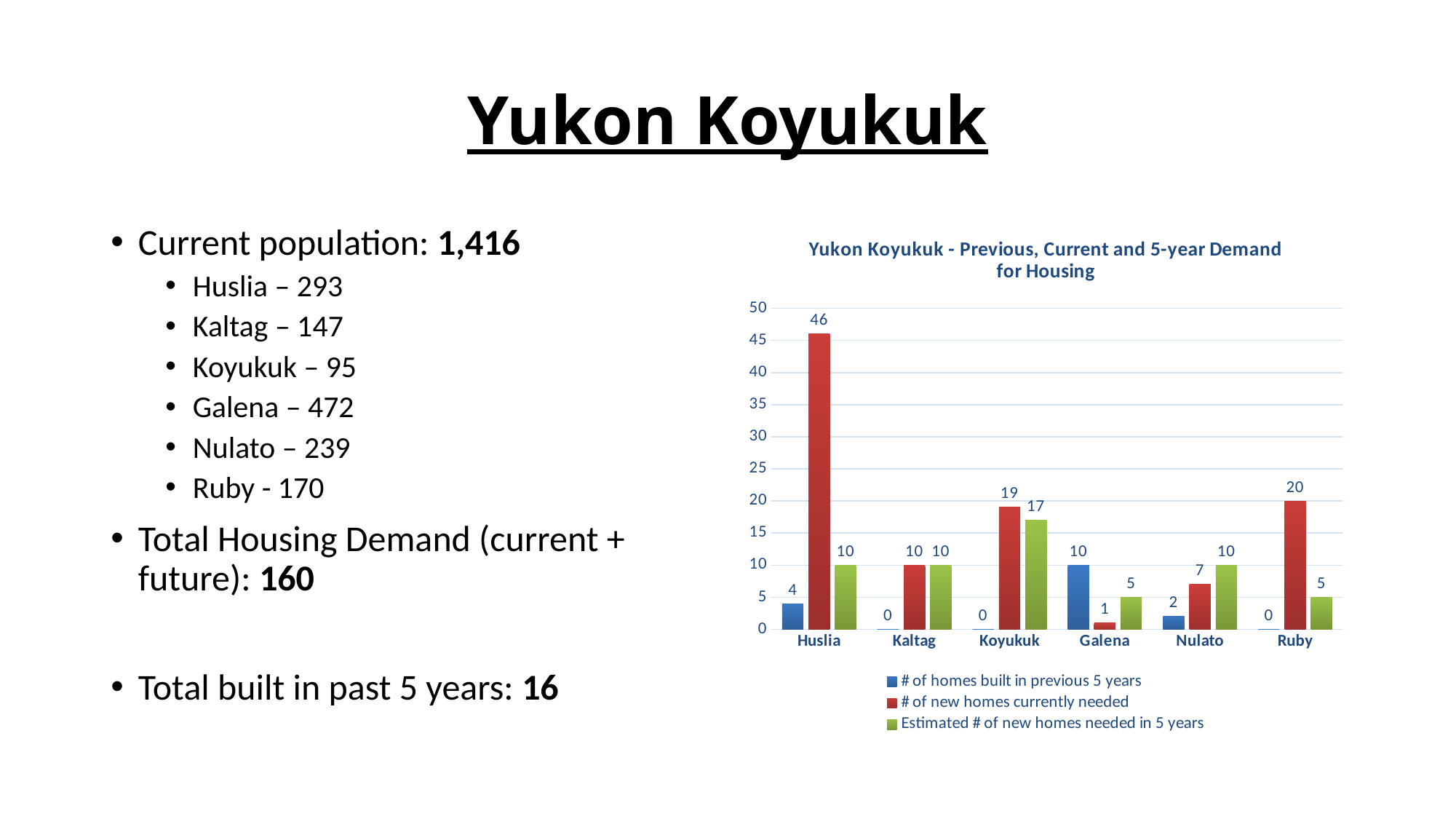
Which colour represents the estimated number of new homes needed in 5 years? Green How many homes were built in Galena in the previous 5 years? 10 Which is larger: the number of homes built in the previous 5 years in Huslia or in Nulato? Huslia What is the estimated number of new homes needed in 5 years for Koyukuk? 17 Which community has the lowest number of new homes currently needed? Galena What is the difference between the number of new homes currently needed in Ruby and in Koyukuk? 1 Which community has the highest number of new homes currently needed? Huslia How many communities are shown on the x axis of the chart? 6 What is the number of new homes currently needed in Huslia? 46 What kind of chart is shown on the slide? Bar chart How many series does the chart legend list? 3 What is the title of the chart? Yukon Koyukuk - Previous, Current and 5-year Demand for Housing